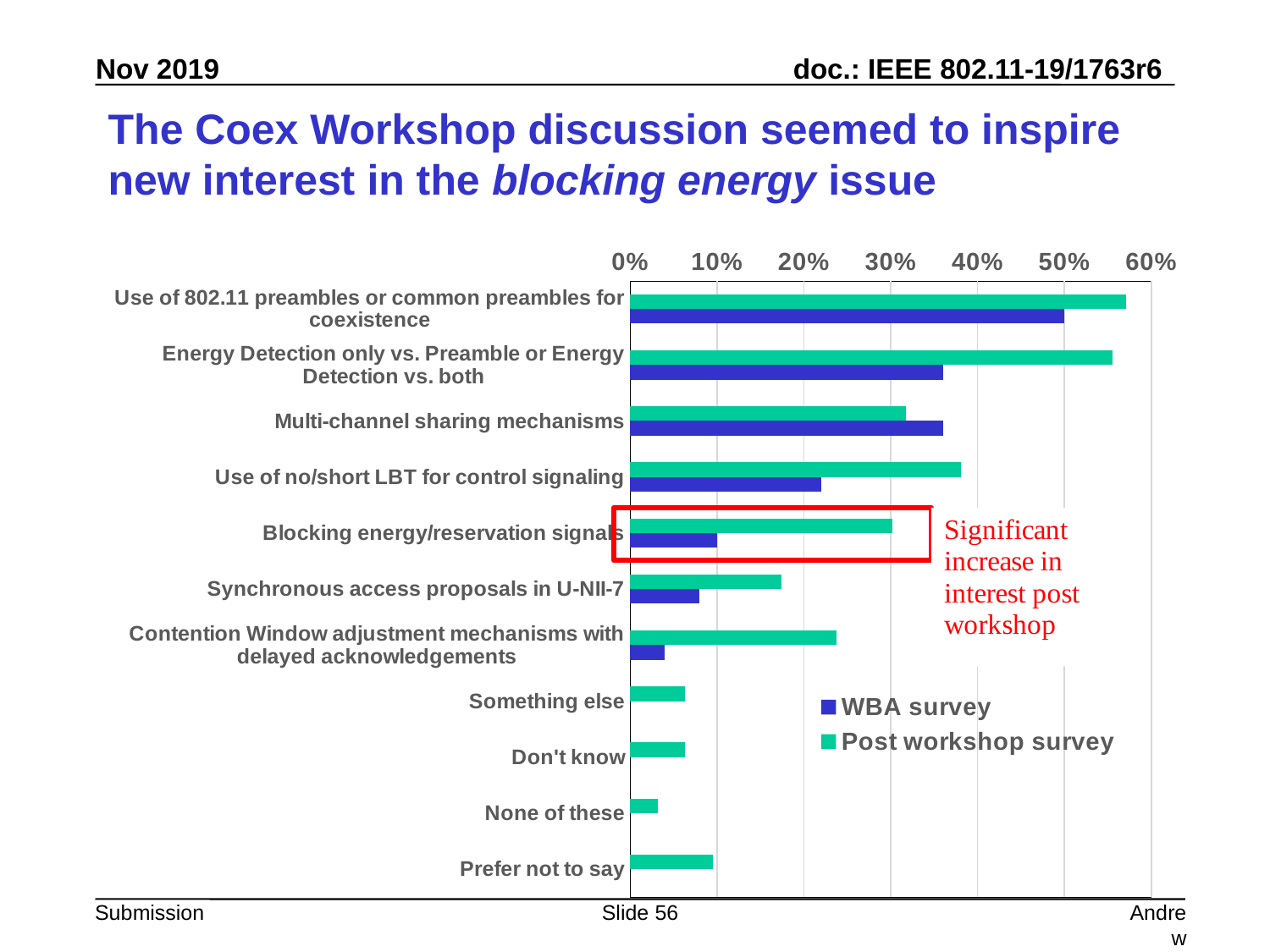
Is the WBA survey value for 'Contention Window adjustment mechanisms with delayed acknowledgements' greater or less than 10%? less Which category has the highest value in the WBA survey series? Use of 802.11 preambles or common preambles for coexistence Is the Post workshop survey value for 'Synchronous access proposals in U-NII-7' greater or less than 20%? less What kind of chart is shown on the slide? Bar chart Which series is shown in blue on the chart? WBA survey Which category on the chart is highlighted with a red box? Blocking energy/reservation signals How many categories are plotted on the chart? 11 Is the WBA survey value for 'Energy Detection only vs. Preamble or Energy Detection vs. both' greater or less than 30%? greater How many series does the chart legend list? 2 For 'Blocking energy/reservation signals', which series has the larger value: WBA survey or Post workshop survey? Post workshop survey For 'Multi-channel sharing mechanisms', which series has the larger value: WBA survey or Post workshop survey? WBA survey